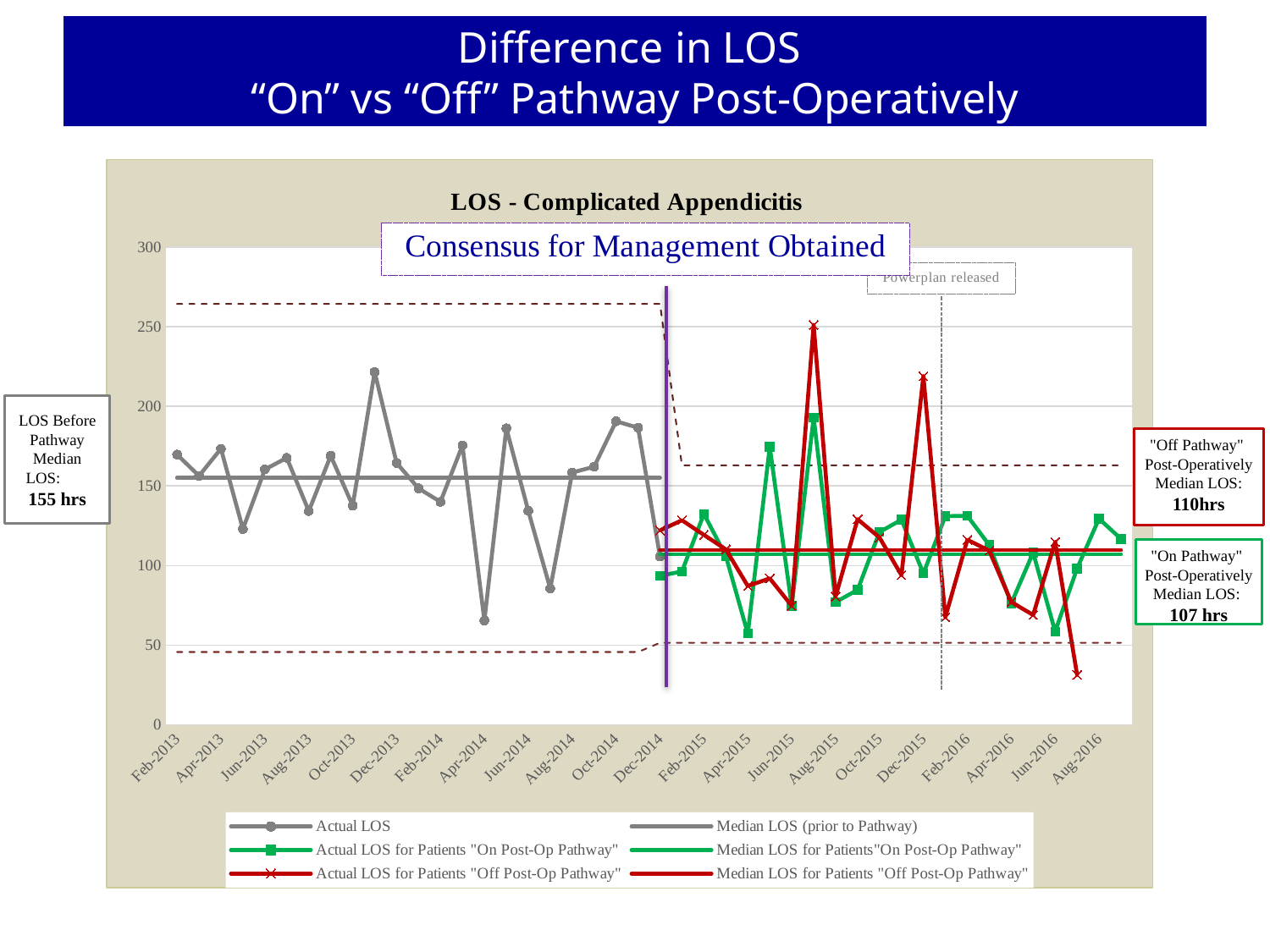
What is the median LOS before the pathway, as stated on the slide? 155 hrs What is the title of the chart? LOS - Complicated Appendicitis How many series does the chart legend list? 6 Which post-operative median LOS is larger, "Off Pathway" or "On Pathway"? Off Pathway What is the difference between the median LOS before the pathway and the "Off Pathway" post-operative median LOS? 45 hrs What type of chart is shown on the slide? line chart What is the "On Pathway" post-operative median LOS? 107 hrs What is the "Off Pathway" post-operative median LOS? 110hrs What is the highest value shown on the vertical axis? 300 What is the difference between the "Off Pathway" and "On Pathway" post-operative median LOS values? 3 hrs Is the highest value of the "Actual LOS for Patients Off Post-Op Pathway" series greater or less than 200? greater